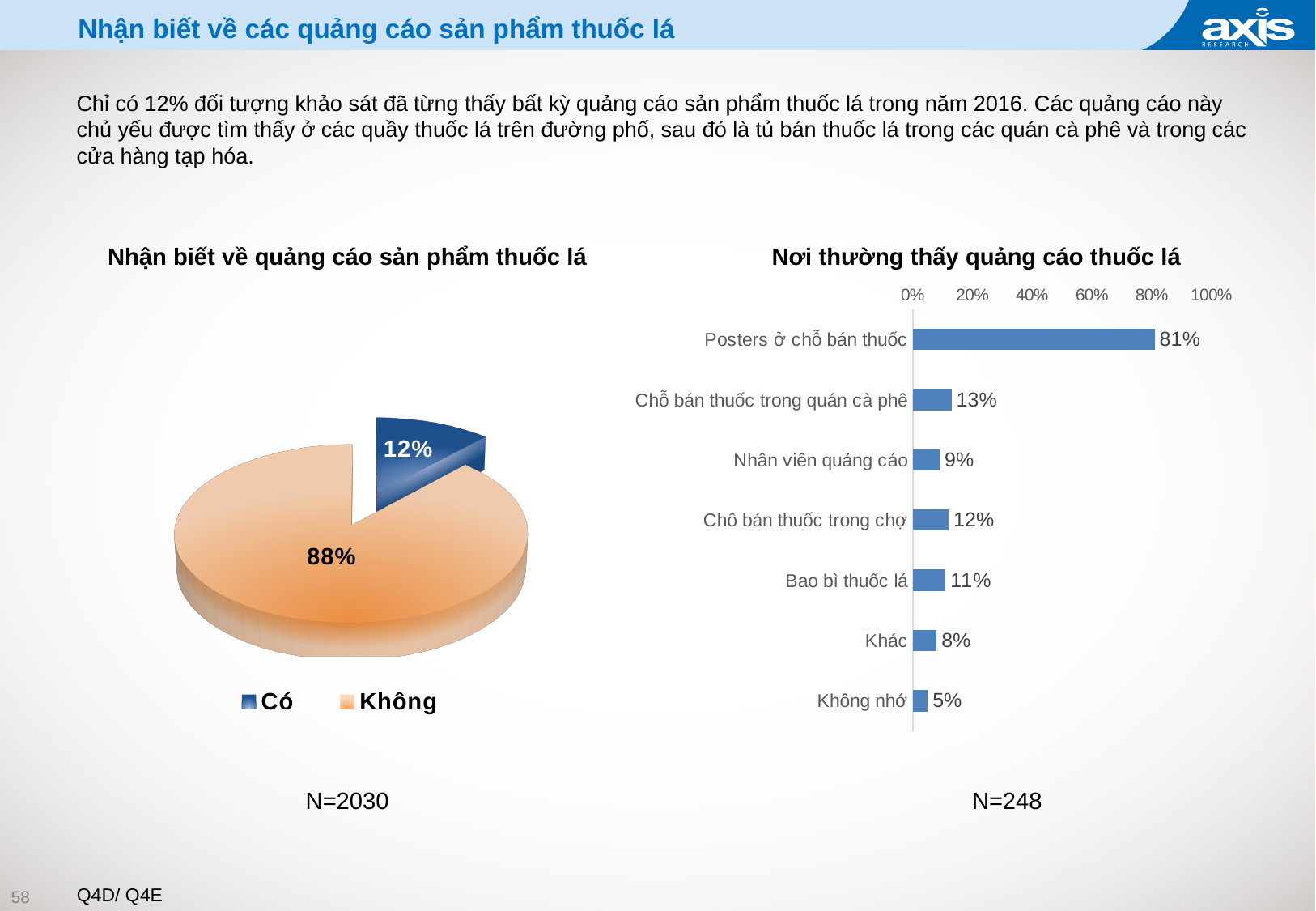
In the chart 'Nhận biết về quảng cáo sản phẩm thuốc lá', what share of respondents answered 'Có'? 12% In the chart 'Nơi thường thấy quảng cáo thuốc lá', what is the value for 'Bao bì thuốc lá'? 11% What kind of chart is 'Nhận biết về quảng cáo sản phẩm thuốc lá'? Pie chart In the chart 'Nơi thường thấy quảng cáo thuốc lá', what is the value for 'Posters ở chỗ bán thuốc'? 81% How many entries does the legend of the chart 'Nhận biết về quảng cáo sản phẩm thuốc lá' list? 2 In the chart 'Nơi thường thấy quảng cáo thuốc lá', which is larger: 'Chô bán thuốc trong chợ' or 'Nhân viên quảng cáo'? Chô bán thuốc trong chợ In the chart 'Nơi thường thấy quảng cáo thuốc lá', which category has the highest value? Posters ở chỗ bán thuốc How many categories are shown in the chart 'Nơi thường thấy quảng cáo thuốc lá'? 7 What kind of chart is 'Nơi thường thấy quảng cáo thuốc lá'? Bar chart In the chart 'Nơi thường thấy quảng cáo thuốc lá', what is the difference between 'Posters ở chỗ bán thuốc' and 'Chỗ bán thuốc trong quán cà phê'? 68% In the chart 'Nhận biết về quảng cáo sản phẩm thuốc lá', what share of respondents answered 'Không'? 88% In the chart 'Nơi thường thấy quảng cáo thuốc lá', which category has the lowest value? Không nhớ